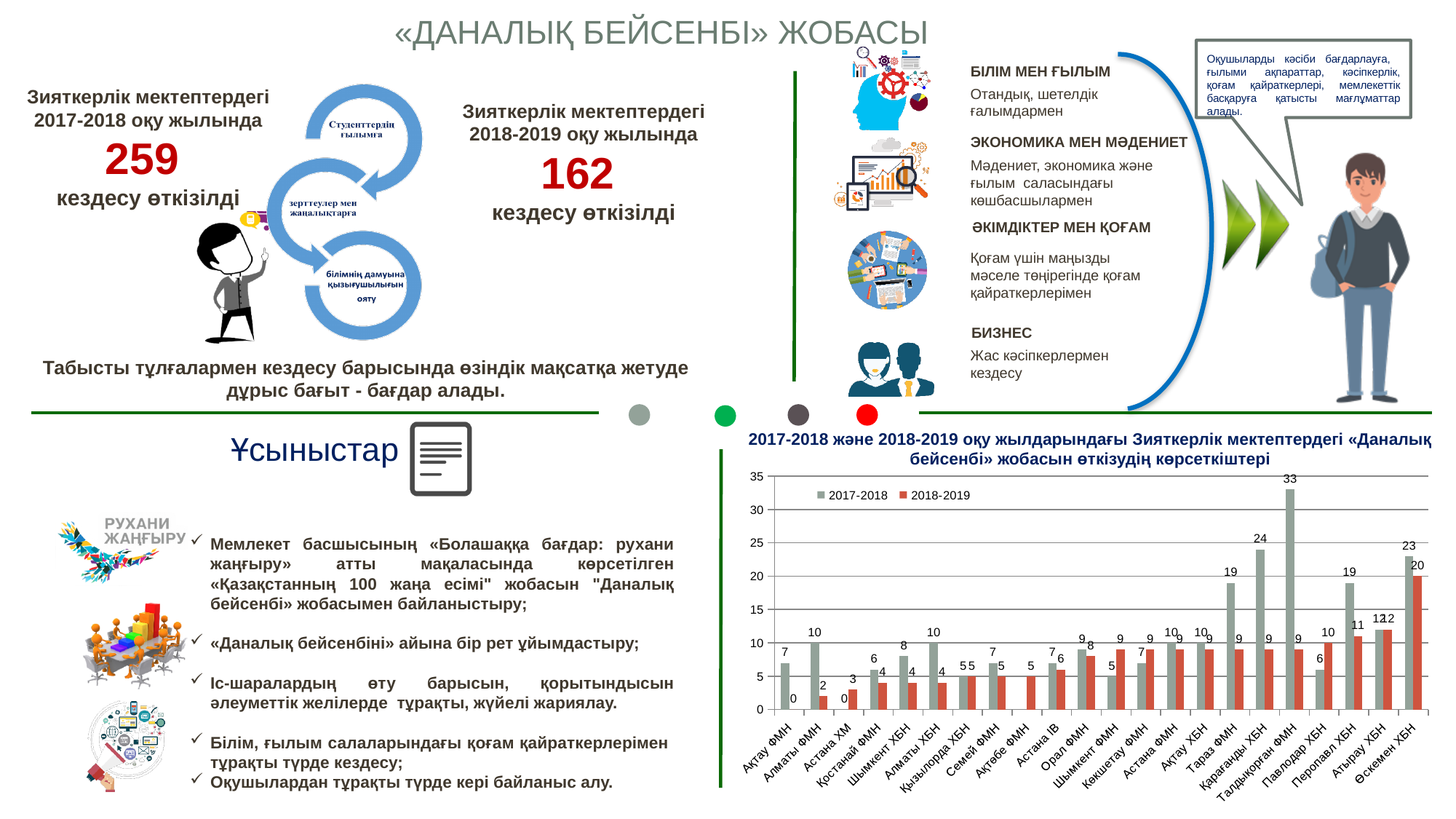
For Павлодар ХБН, which series has the larger value, 2017-2018 or 2018-2019? 2018-2019 Which school has the highest 2017-2018 value in the bar chart? Талдықорған ФМН Which colour represents the 2018-2019 series in the bar chart? red Which school has the highest 2018-2019 value in the bar chart? Өскемен ХБН What is the difference between the 2017-2018 and 2018-2019 values for Қарағанды ХБН? 15 What type of chart is shown at the bottom right of the slide? bar chart What is the 2017-2018 value for Петропавл ХБН in the bar chart? 19 How many school categories are shown on the x axis of the bar chart? 22 What is the 2018-2019 value for Ақтау ФМН in the bar chart? 0 What is the 2017-2018 value for Талдықорған ФМН in the bar chart? 33 What is the 2018-2019 value for Өскемен ХБН in the bar chart? 20 How many series does the legend of the bar chart list? 2